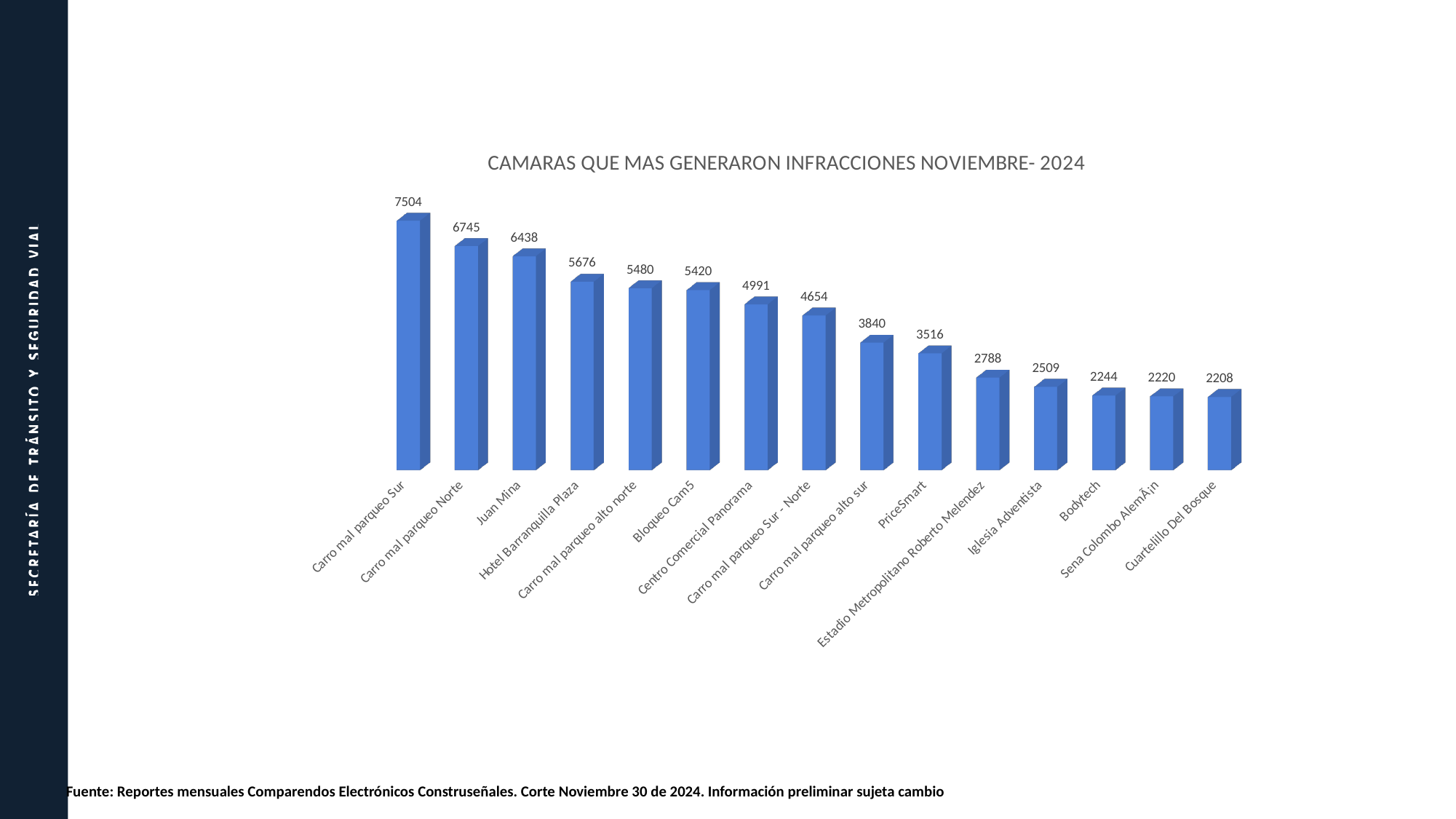
What is the value for Carro mal parqueo Sur? 7504 What kind of chart is this? Bar chart What is the value for Hotel Barranquilla Plaza? 5676 What is the title of the chart? CAMARAS QUE MAS GENERARON INFRACCIONES NOVIEMBRE- 2024 How many cameras are shown in the chart? 15 What is the value for PriceSmart? 3516 What is the difference between Bloqueo Cam5 and Centro Comercial Panorama? 429 Which is larger, Juan Mina or Carro mal parqueo alto norte? Juan Mina What is the difference between Carro mal parqueo Sur and Carro mal parqueo Norte? 759 Which camera has the highest value? Carro mal parqueo Sur Which camera has the lowest value? Cuartelillo Del Bosque What is the value for Iglesia Adventista? 2509